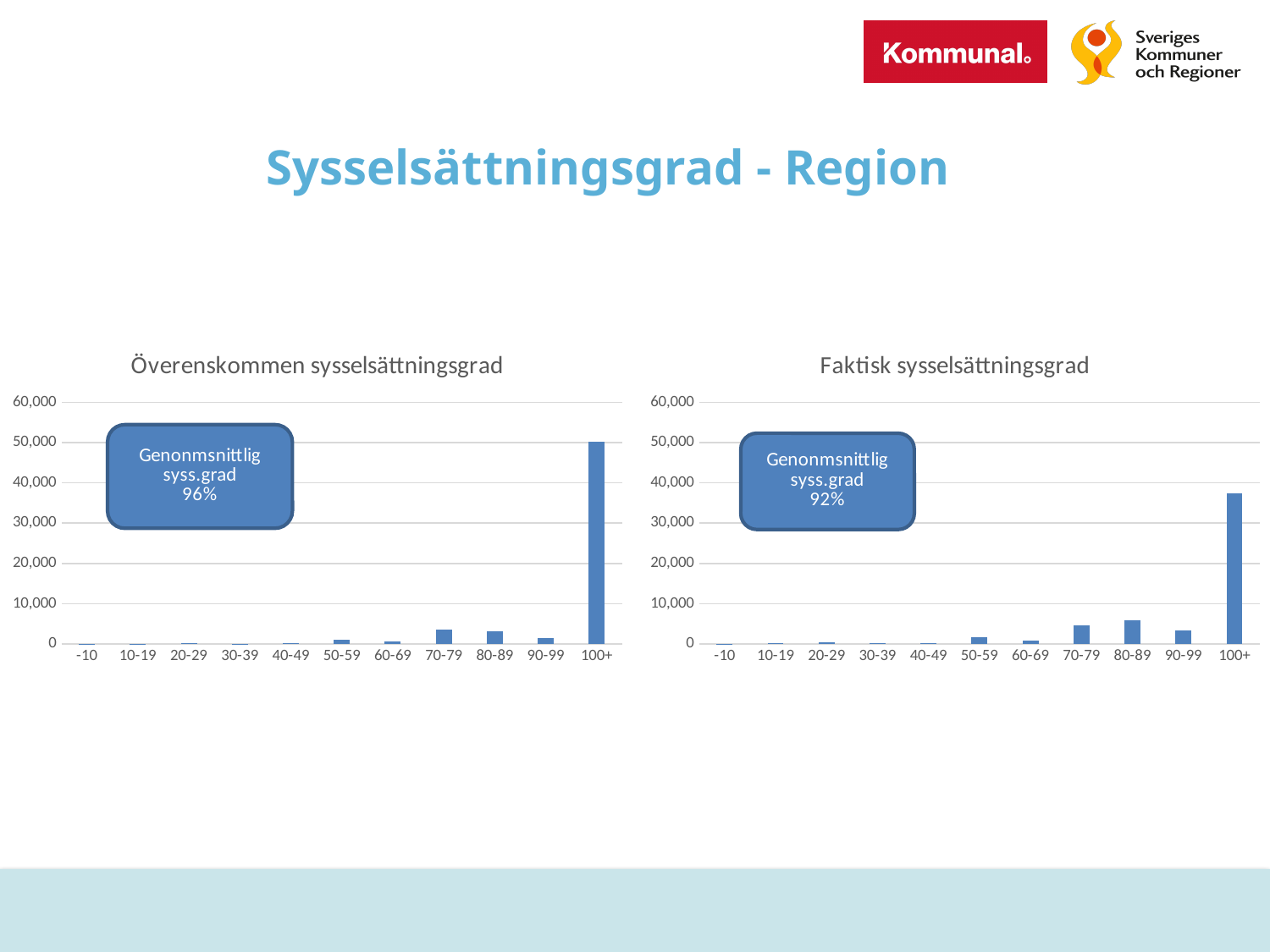
In the "Överenskommen sysselsättningsgrad" chart, is the value for 100+ greater or less than 40,000? greater What average employment rate (Genonmsnittlig syss.grad) is shown in the box on the "Faktisk sysselsättningsgrad" chart? 92% In the "Faktisk sysselsättningsgrad" chart, is the value for 100+ greater or less than 30,000? greater In the "Överenskommen sysselsättningsgrad" chart, which category has the highest value? 100+ In the "Faktisk sysselsättningsgrad" chart, is the value for 100+ greater or less than 40,000? less In the "Faktisk sysselsättningsgrad" chart, which category has the highest value? 100+ What type of chart is "Överenskommen sysselsättningsgrad"? bar chart How many categories are shown on the x axis of the "Faktisk sysselsättningsgrad" chart? 11 In the "Överenskommen sysselsättningsgrad" chart, which is larger, the value for 70-79 or the value for 90-99? 70-79 In the "Faktisk sysselsättningsgrad" chart, which is larger, the value for 80-89 or the value for 90-99? 80-89 What average employment rate (Genonmsnittlig syss.grad) is shown in the box on the "Överenskommen sysselsättningsgrad" chart? 96%